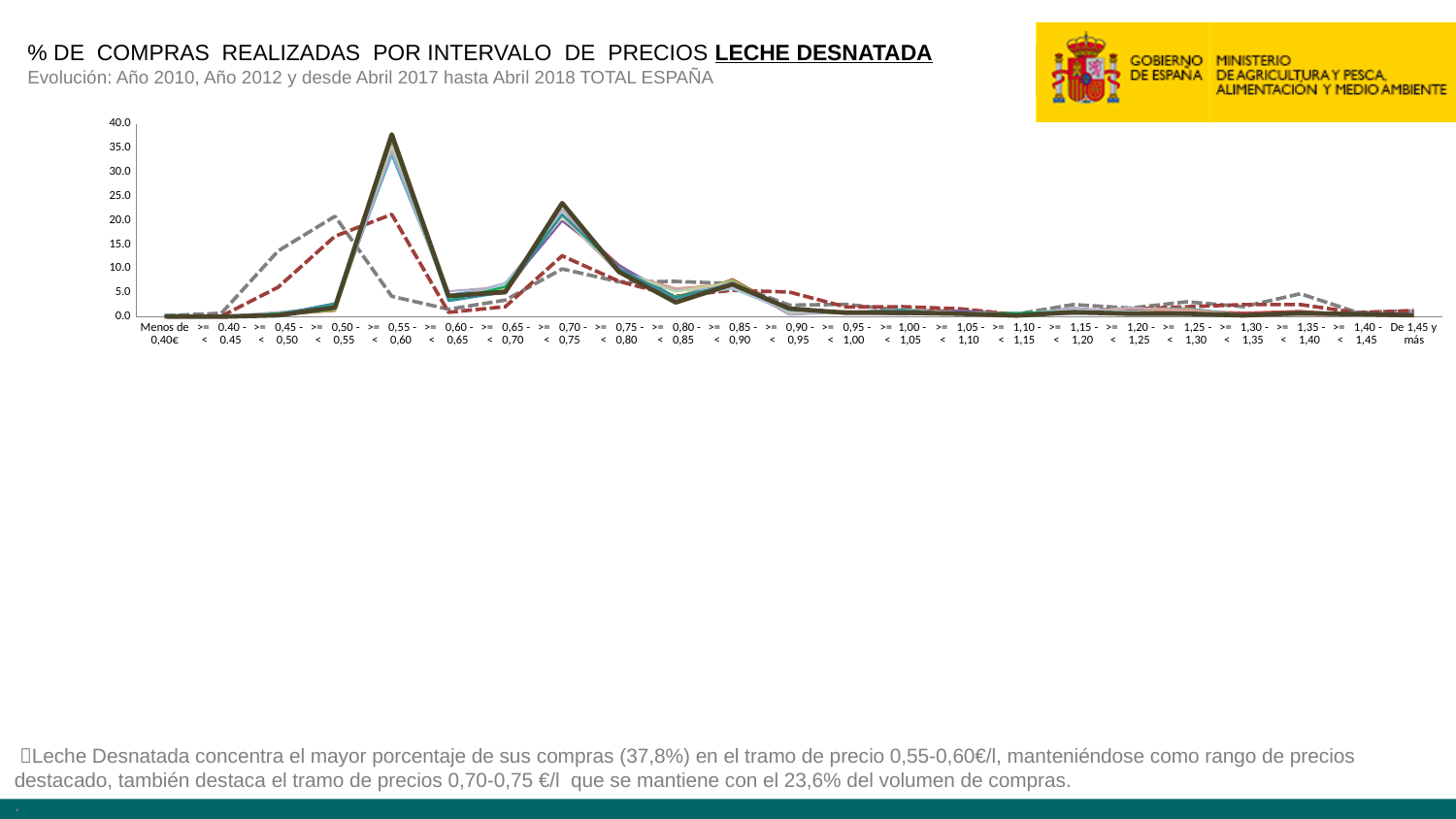
Do the values rise or fall from the >= 0,55 - < 0,60 interval to the >= 0,60 - < 0,65 interval? fall What kind of chart is shown on the slide? line chart Is the value at the >= 0,85 - < 0,90 interval greater or less than 10.0? less Which product is named in the chart title on the slide? LECHE DESNATADA Is the peak value at the >= 0,55 - < 0,60 interval greater or less than 35.0? greater Which interval has the larger value, >= 0,55 - < 0,60 or >= 0,70 - < 0,75? >= 0,55 - < 0,60 Which price interval has the highest value on the chart? >= 0,55 - < 0,60 Is the value at the >= 0,70 - < 0,75 interval greater or less than 25.0? less What is the highest tick value shown on the y axis of the chart? 40.0 How many price intervals are shown along the x axis of the chart? 23